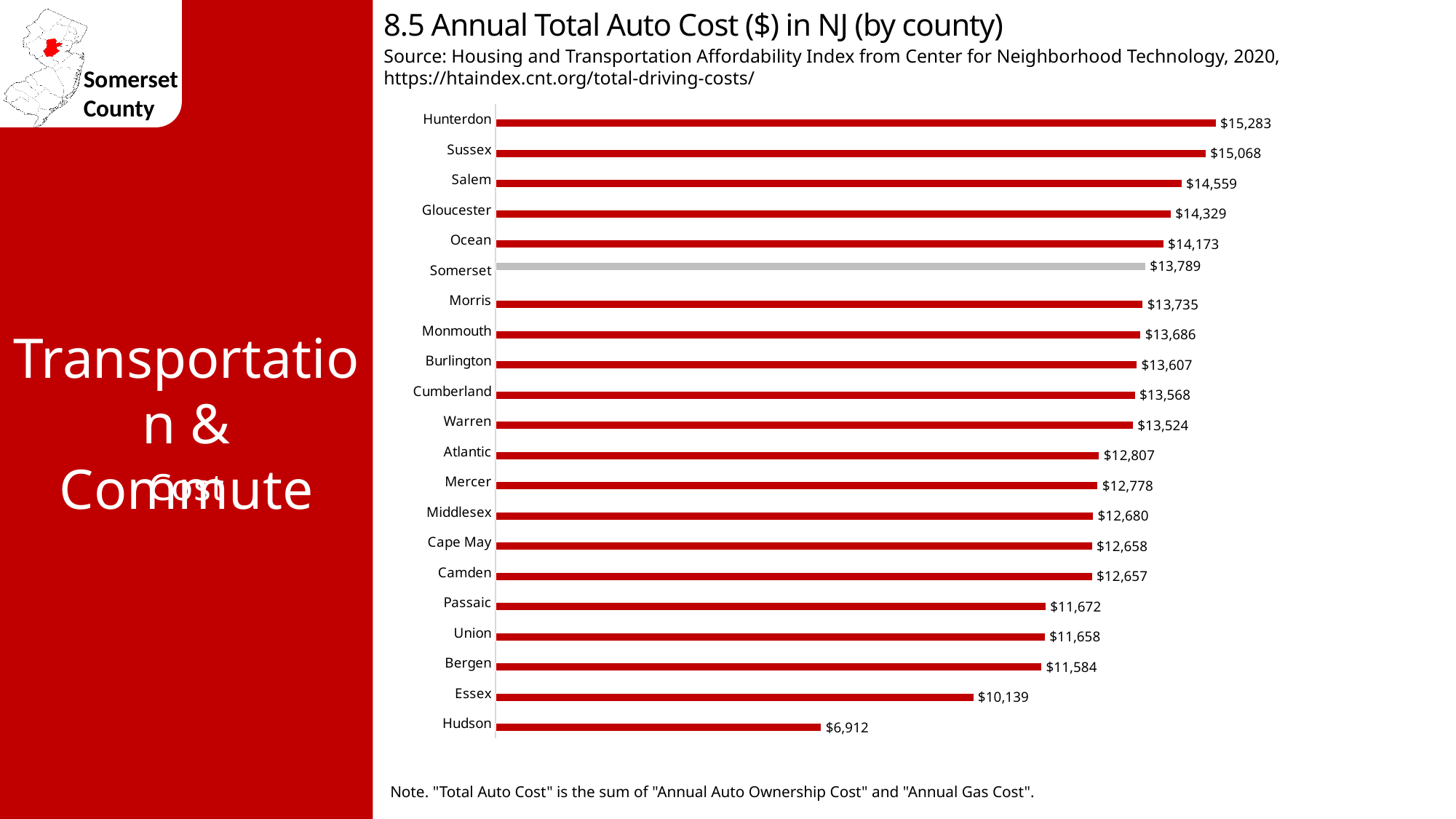
Which county has a higher annual total auto cost, Sussex or Salem? Sussex Which county has a higher annual total auto cost, Essex or Bergen? Bergen What is the difference between the annual total auto cost for Somerset and Morris? $54 What is the difference between the annual total auto cost for Hunterdon and Hudson? $8,371 How many counties are shown in the chart? 21 What is the annual total auto cost for Somerset county? $13,789 What is the annual total auto cost for Ocean county? $14,173 Which county has the highest annual total auto cost? Hunterdon What is the annual total auto cost for Hudson county? $6,912 What type of chart is used to show annual total auto cost by county? Bar chart Which county has the lowest annual total auto cost? Hudson Which county's bar is shown in gray instead of red? Somerset